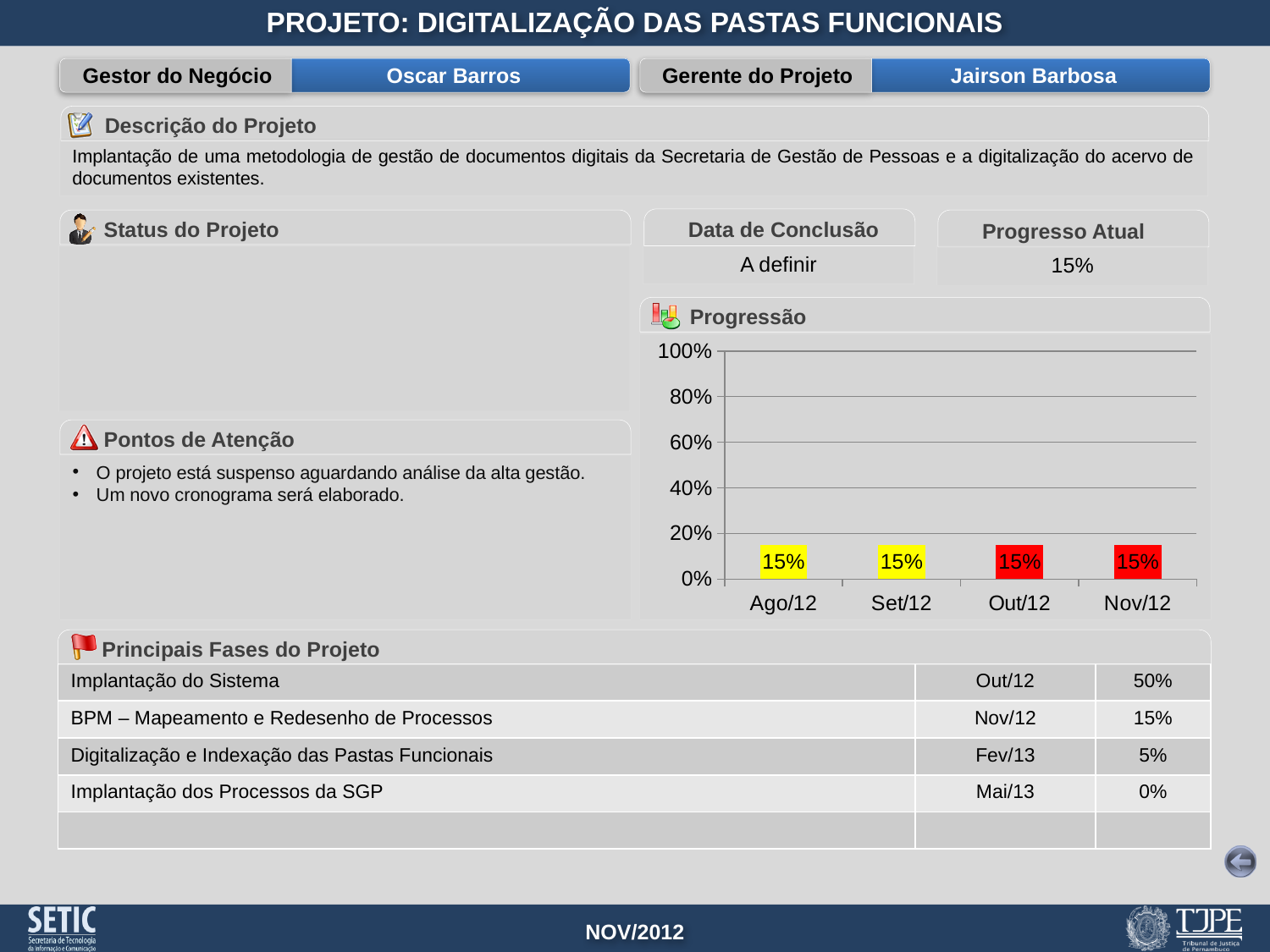
What is the value for Ago/12 in the Progressão chart? 15% What kind of chart is the Progressão chart? bar chart What is the value for Out/12 in the Progressão chart? 15% How many months are shown on the x axis of the Progressão chart? 4 Do the values in the Progressão chart rise, fall, or stay flat from Ago/12 to Nov/12? stay flat What is the highest value shown on the y axis of the Progressão chart? 100% What is the value for Set/12 in the Progressão chart? 15% What is the difference between the values for Ago/12 and Nov/12 in the Progressão chart? 0% Is the value for Out/12 in the Progressão chart greater or less than 20%? less What is the value for Nov/12 in the Progressão chart? 15% Which month is the first category on the x axis of the Progressão chart? Ago/12 What is the title of the chart on the slide? Progressão